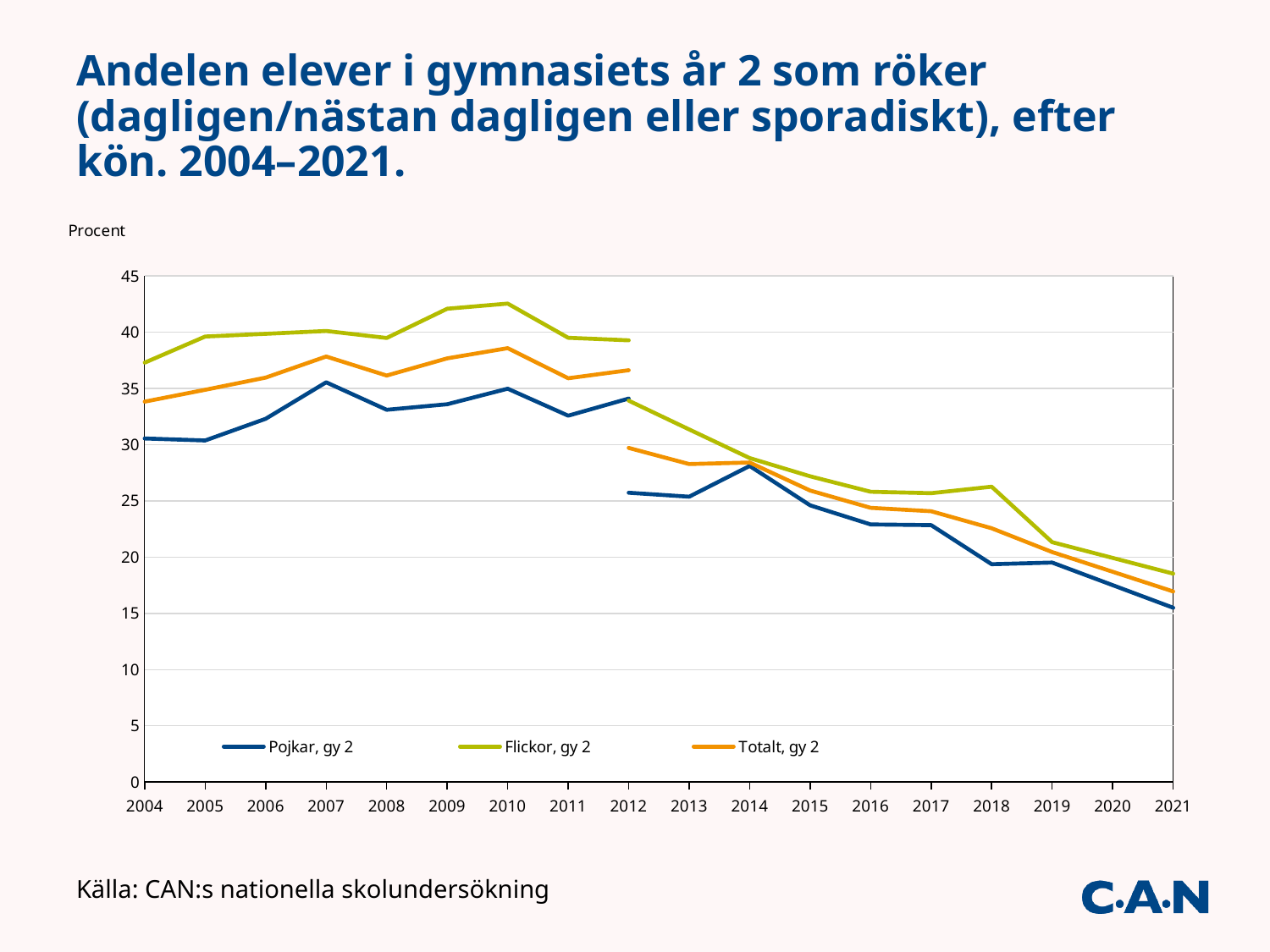
How many series does the legend list? 3 In 2018, which is larger: the value for Flickor, gy 2 or the value for Pojkar, gy 2? Flickor, gy 2 Is the value for Pojkar, gy 2 in 2021 greater or less than 20? less Do the values for Pojkar, gy 2 rise or fall from 2014 to 2021? Fall In which year is the value for Pojkar, gy 2 lowest? 2021 Is the value for Totalt, gy 2 in 2004 greater or less than 30? greater What kind of chart is shown on the slide? Line chart Is the value for Flickor, gy 2 in 2010 greater or less than 40? greater What label is shown above the y axis? Procent In which year is the value for Flickor, gy 2 lowest? 2021 How many years are shown along the x axis? 18 Which series is highest in 2004? Flickor, gy 2